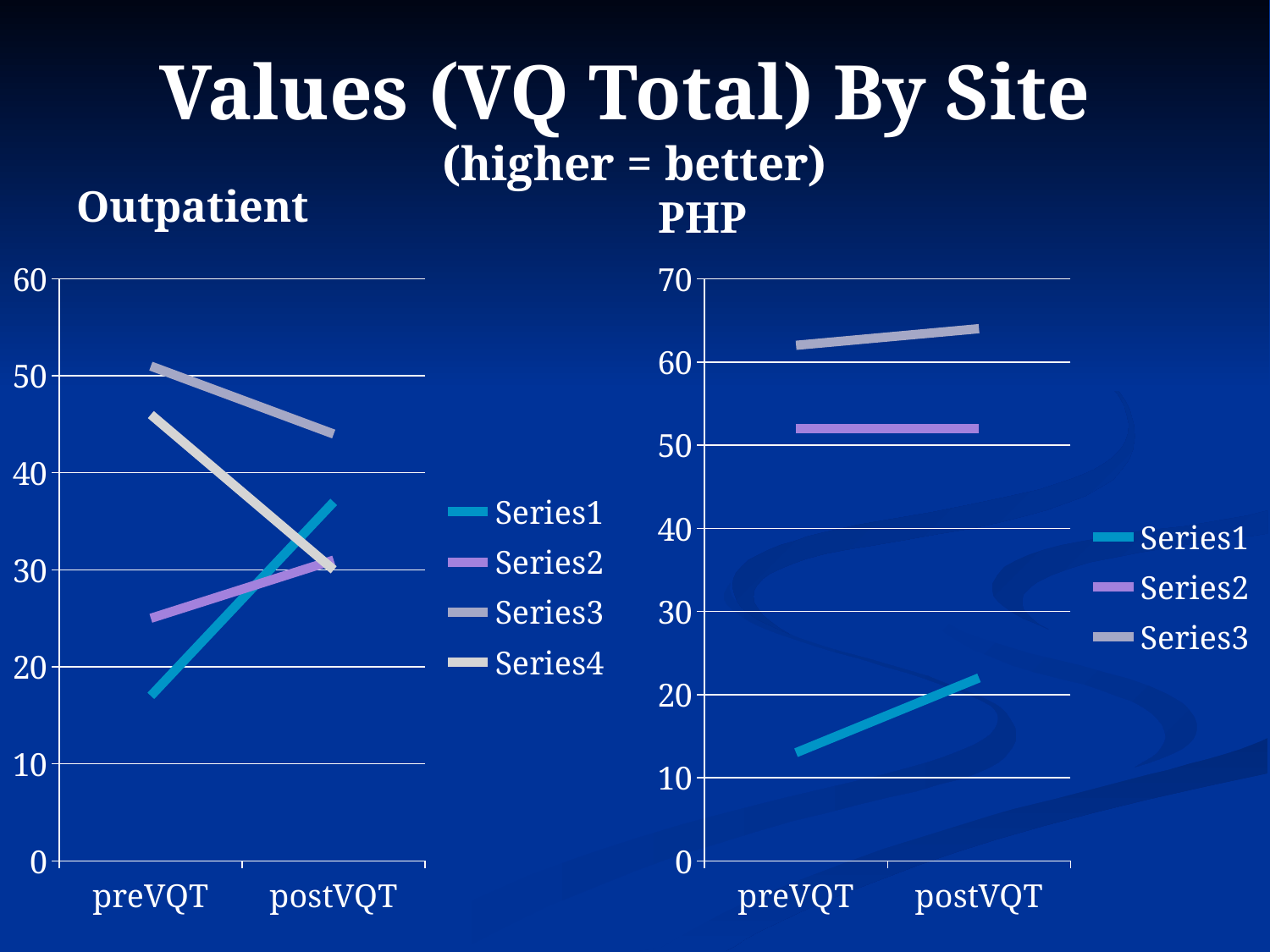
In the Outpatient chart, which is larger at postVQT: Series1 or Series2? Series1 In the PHP chart, does Series1 rise or fall from preVQT to postVQT? rise How many categories are shown on the x axis of the PHP chart? 2 In the Outpatient chart, is the value for Series1 at preVQT greater or less than 20? less In the Outpatient chart, does Series1 rise or fall from preVQT to postVQT? rise How many series does the legend of the Outpatient chart list? 4 In the Outpatient chart, does Series3 rise or fall from preVQT to postVQT? fall What kind of chart is the Outpatient chart? line chart In the PHP chart, is the value for Series3 at preVQT greater or less than 60? greater How many series does the legend of the PHP chart list? 3 In the PHP chart, which series has the highest value at postVQT? Series3 In the Outpatient chart, which series has the lowest value at preVQT? Series1